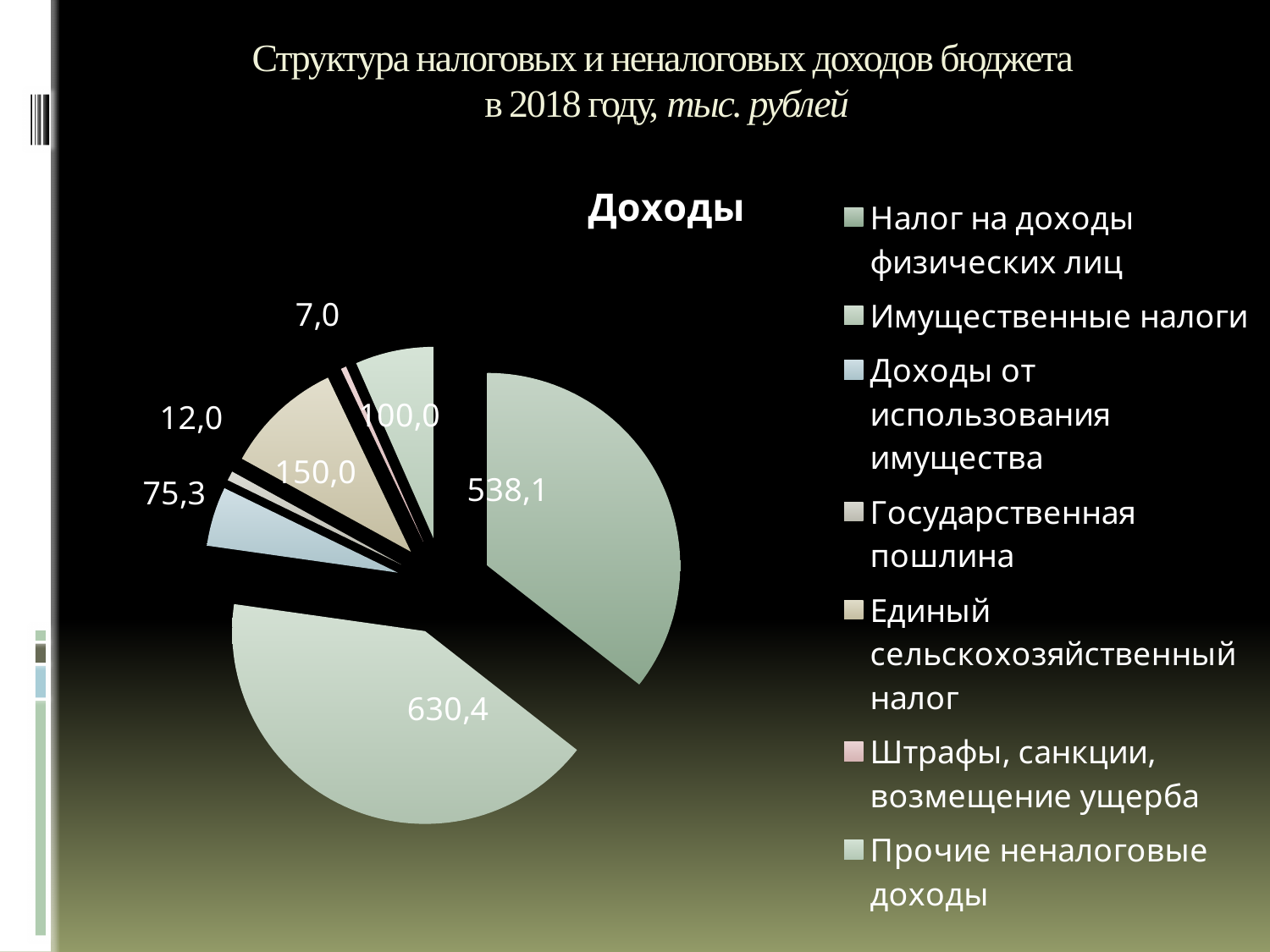
What is the value for Налог на доходы физических лиц? 538,1 What is the difference between Имущественные налоги and Налог на доходы физических лиц? 92,3 Which category has the largest slice? Имущественные налоги What is the title of the chart? Доходы What is the difference between Единый сельскохозяйственный налог and Прочие неналоговые доходы? 50,0 What is the value for Единый сельскохозяйственный налог? 150,0 Which category has the smallest slice? Штрафы, санкции, возмещение ущерба Which is larger: Доходы от использования имущества or Прочие неналоговые доходы? Прочие неналоговые доходы What is the value for Штрафы, санкции, возмещение ущерба? 7,0 How many categories does the legend list? 7 What kind of chart is shown on the slide? pie chart What is the value for Имущественные налоги? 630,4